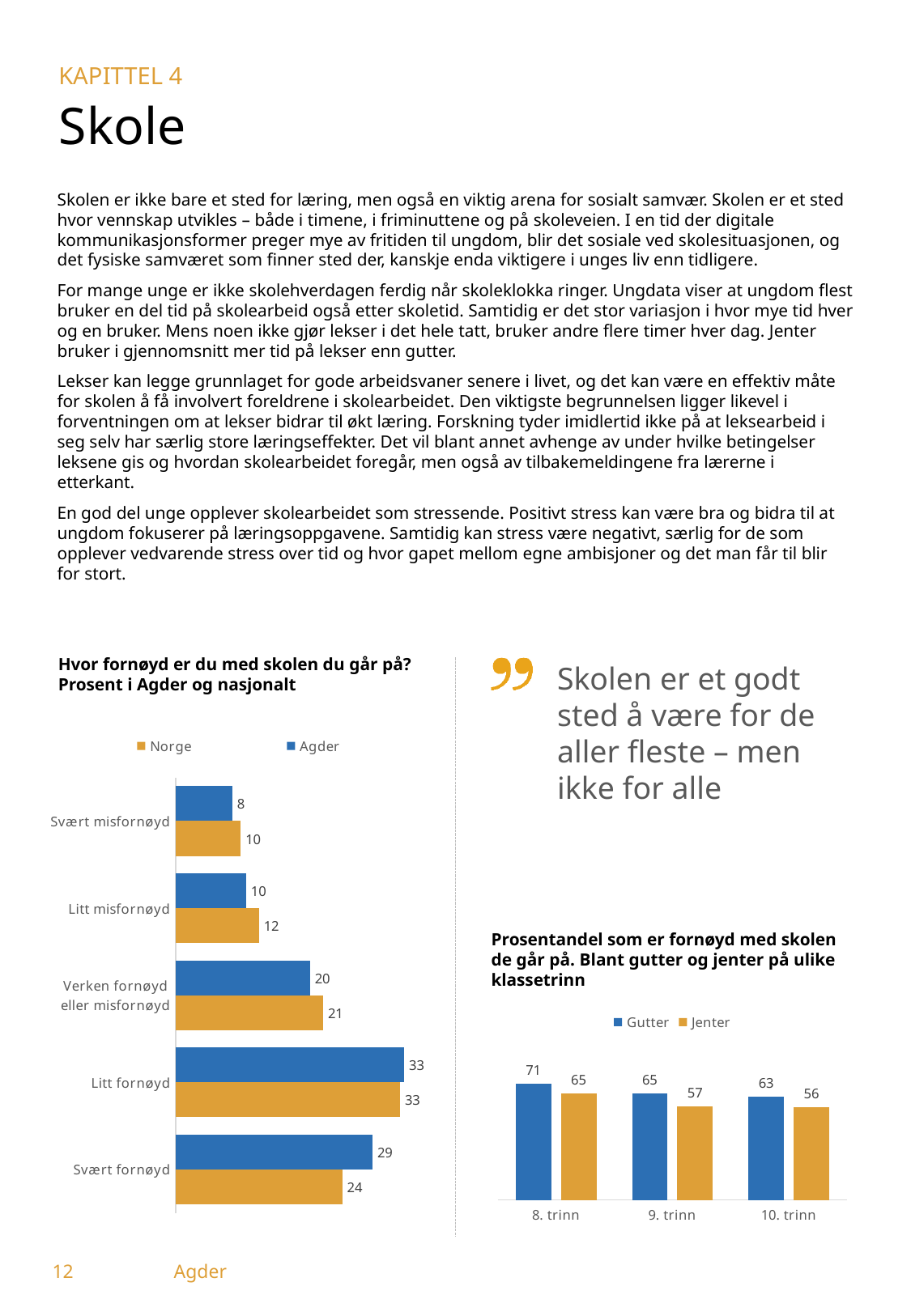
In the chart 'Hvor fornøyd er du med skolen du går på?', what is the difference between Agder and Norge for 'Svært fornøyd'? 5 In the chart 'Hvor fornøyd er du med skolen du går på?', what is the value for Norge in the category 'Litt misfornøyd'? 12 In the chart 'Prosentandel som er fornøyd med skolen de går på', do the values for Gutter rise or fall from 8. trinn to 10. trinn? fall In the chart 'Hvor fornøyd er du med skolen du går på?', what is the value for Agder in the category 'Svært fornøyd'? 29 In the chart 'Hvor fornøyd er du med skolen du går på?', how many series does the legend list? 2 In the chart 'Prosentandel som er fornøyd med skolen de går på', what is the value for Jenter in 9. trinn? 57 In the chart 'Prosentandel som er fornøyd med skolen de går på', what is the difference between Gutter and Jenter in 10. trinn? 7 In the chart 'Hvor fornøyd er du med skolen du går på?', which category has the highest value for Agder? Litt fornøyd In the chart 'Prosentandel som er fornøyd med skolen de går på', which group has the highest value for Gutter? 8. trinn In the chart 'Hvor fornøyd er du med skolen du går på?', how many categories are shown? 5 In the chart 'Hvor fornøyd er du med skolen du går på?', which category has the lowest value for Norge? Svært misfornøyd What kind of chart is 'Prosentandel som er fornøyd med skolen de går på'? bar chart